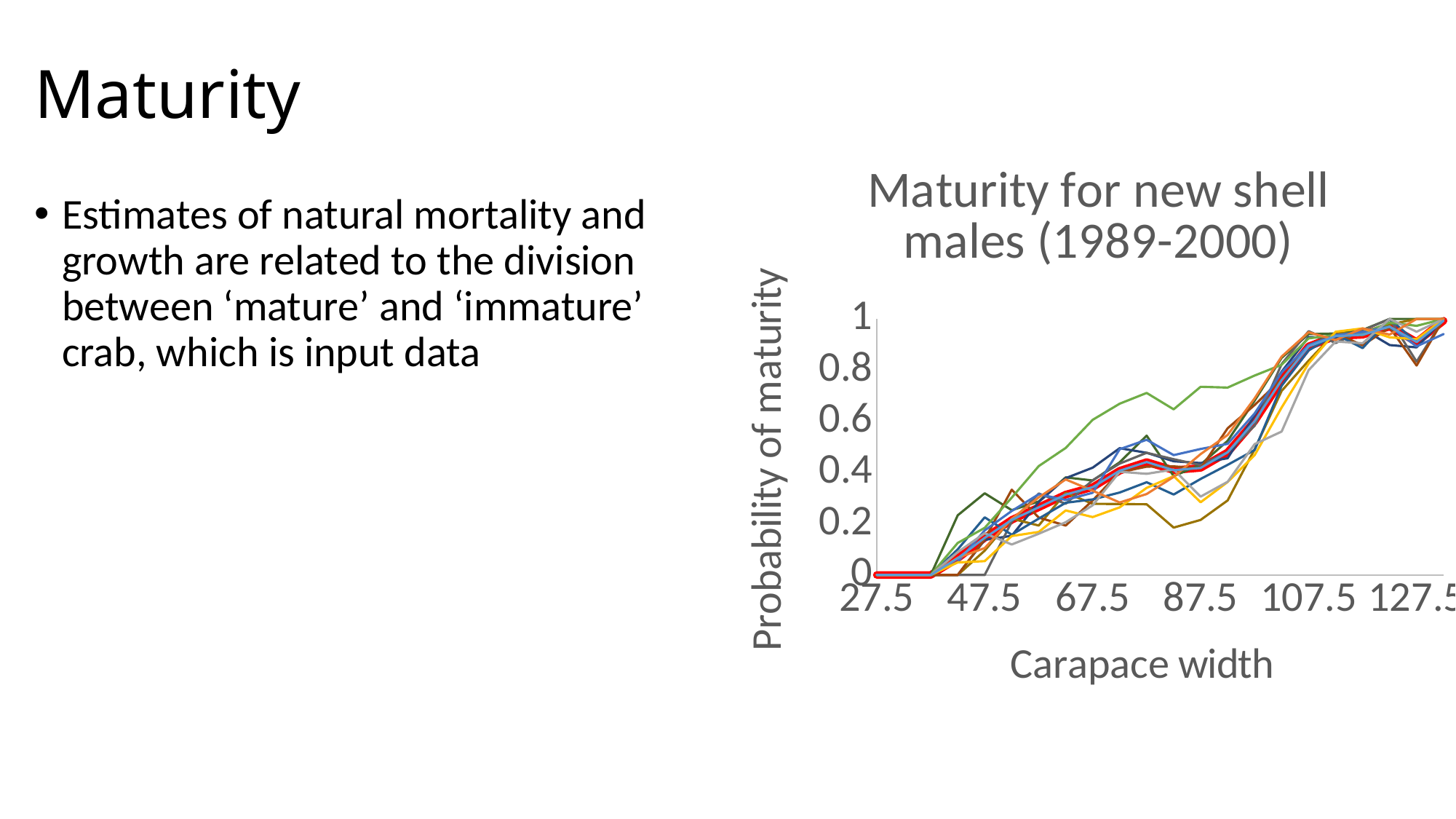
What is the title of the chart? Maturity for new shell males (1989-2000) Is the value of the thick red line at a carapace width of 127.5 greater or less than 0.8? greater Is the value of the thick red line at a carapace width of 27.5 greater or less than 0.2? less What is the label of the y axis of the chart? Probability of maturity What kind of chart is shown on the slide? Line chart Is the value of the thick red line at a carapace width of 107.5 greater or less than 0.6? greater Do the lines in the chart generally rise or fall as carapace width increases? Rise